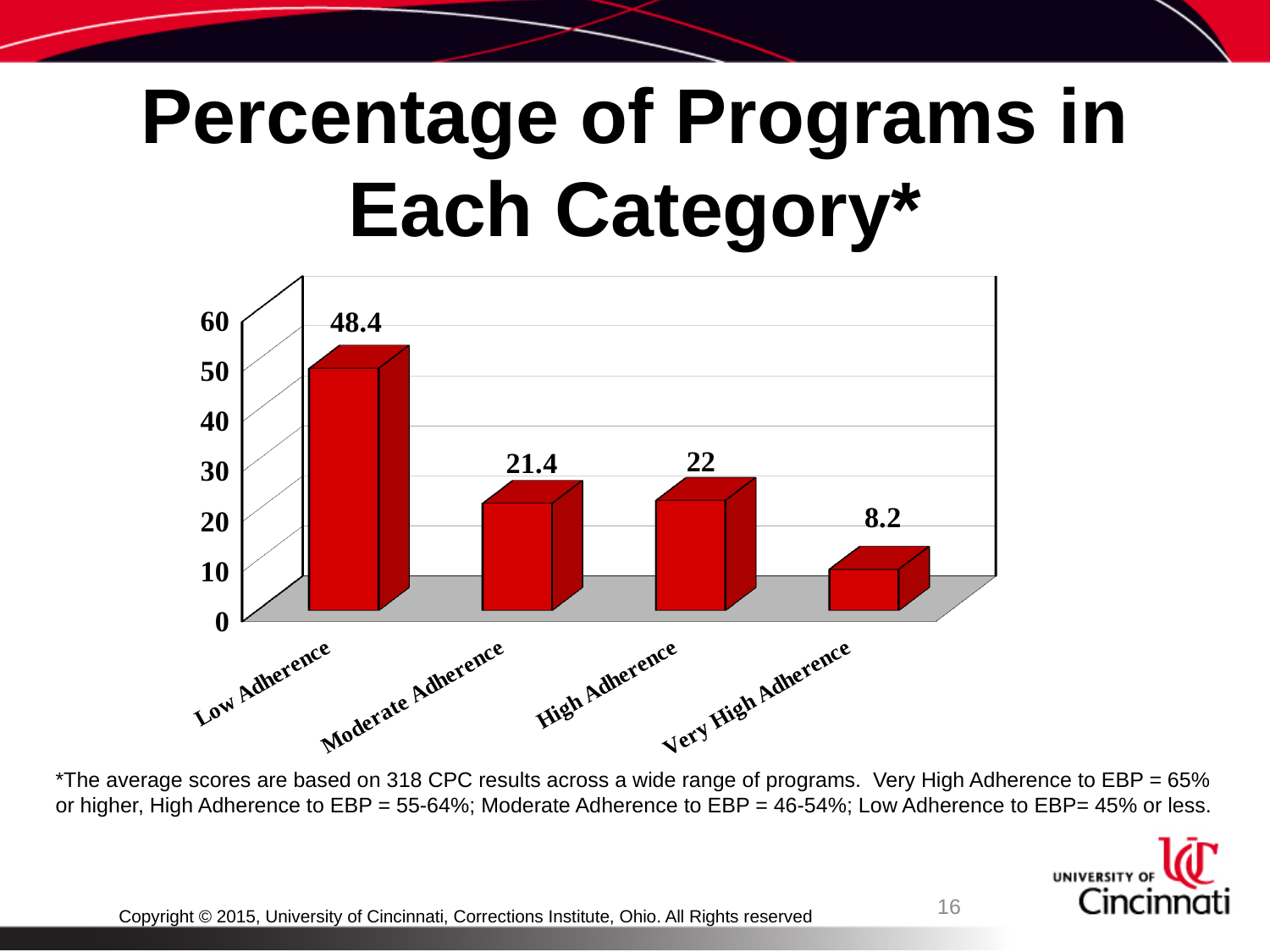
What is the value for Moderate Adherence? 21.4 What is the difference between the values for High Adherence and Moderate Adherence? 0.6 What kind of chart is shown on the slide? Bar chart What is the value for High Adherence? 22 Which is larger, the value for Low Adherence or the value for High Adherence? Low Adherence Which category has the highest value? Low Adherence Is the value for Low Adherence greater or less than 40? greater What is the value for Very High Adherence? 8.2 What is the value for Low Adherence? 48.4 What is the difference between the values for Low Adherence and Very High Adherence? 40.2 Which category has the lowest value? Very High Adherence How many categories are shown in the chart? 4